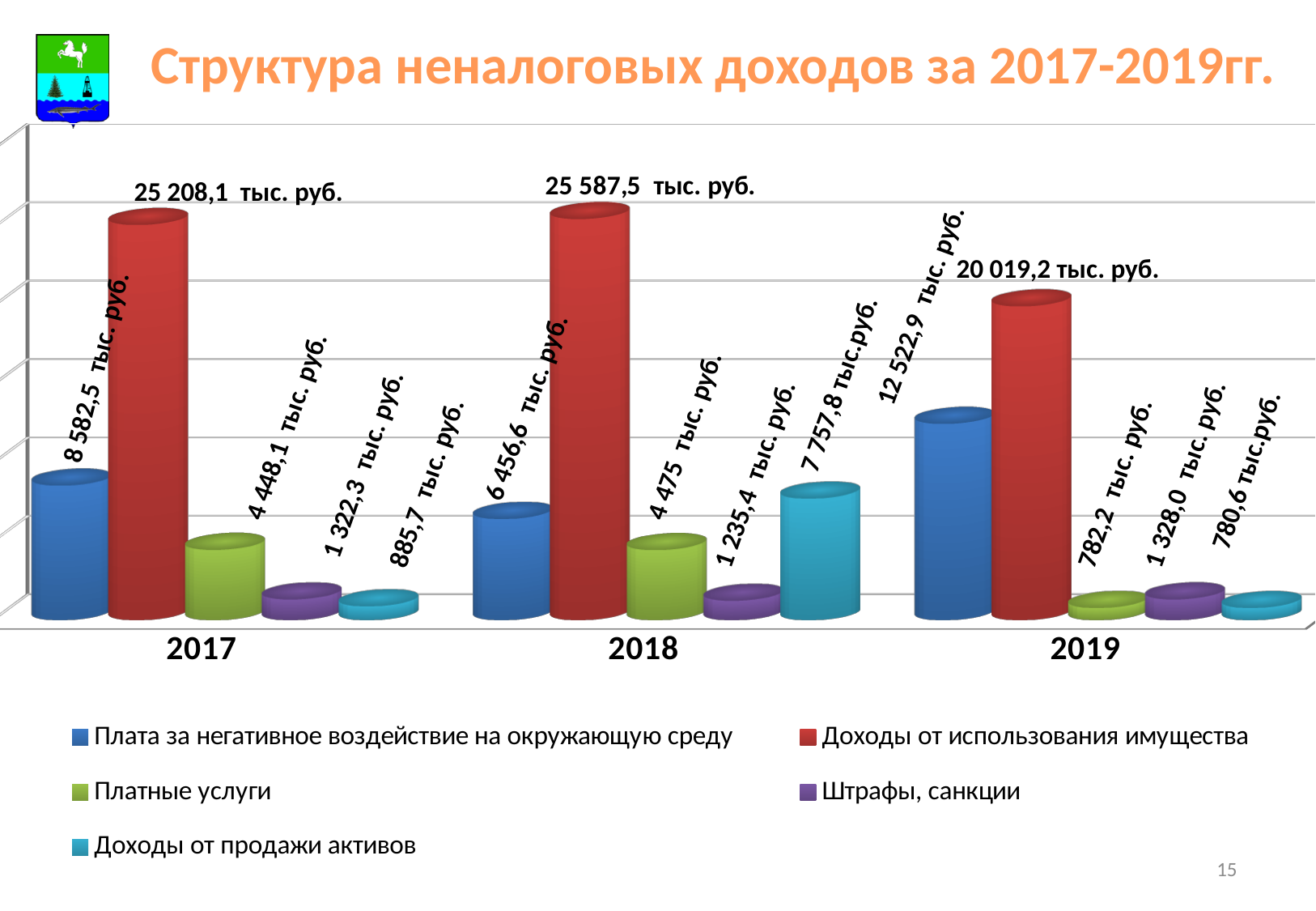
What is the value for Доходы от использования имущества in 2017? 25 208,1 тыс. руб. In 2018, which is larger: Доходы от продажи активов or Плата за негативное воздействие на окружающую среду? Доходы от продажи активов Which series has the highest value in 2018? Доходы от использования имущества Which series has the lowest value in 2017? Доходы от продажи активов What is the difference between the values for Доходы от использования имущества in 2018 and 2017? 379,4 тыс. руб. What kind of chart is shown on the slide? Bar chart What is the value for Плата за негативное воздействие на окружающую среду in 2019? 12 522,9 тыс. руб. What is the value for Доходы от продажи активов in 2018? 7 757,8 тыс. руб. What is the value for Штрафы, санкции in 2017? 1 322,3 тыс. руб. How many years are shown on the x axis? 3 What is the difference between the values for Плата за негативное воздействие на окружающую среду in 2019 and 2017? 3 940,4 тыс. руб. How many series does the legend list? 5